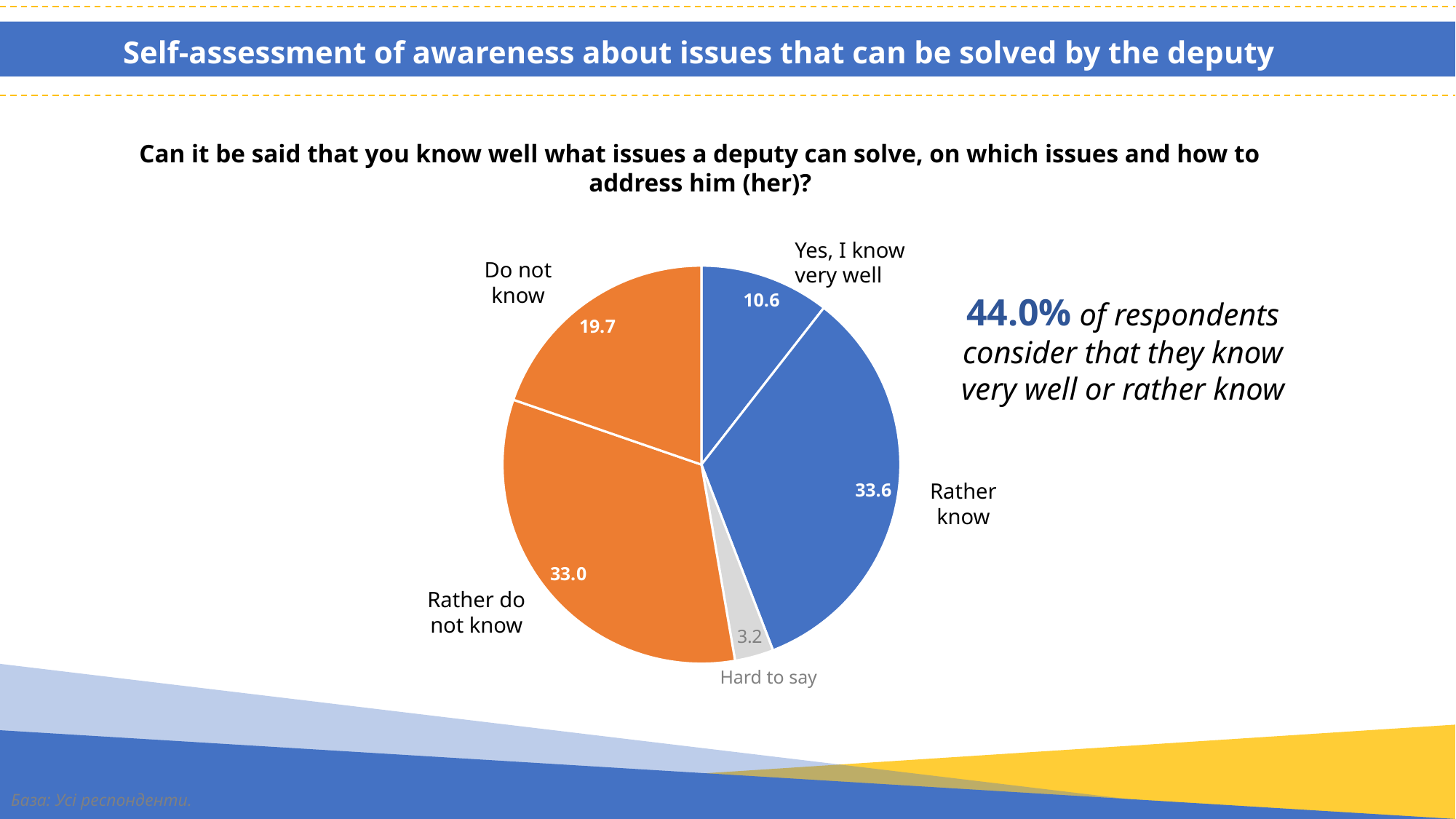
How many slices does the pie chart have? 5 Which is larger: the value for "Do not know" or the value for "Yes, I know very well"? Do not know What type of chart is shown on the slide? Pie chart What is the value for "Rather know" in the pie chart? 33.6 Which category has the smallest slice in the pie chart? Hard to say What is the value for "Rather do not know" in the pie chart? 33.0 What is the value for "Do not know" in the pie chart? 19.7 What is the title of the slide containing the pie chart? Self-assessment of awareness about issues that can be solved by the deputy What is the difference between the values for "Rather know" and "Yes, I know very well"? 23.0 What is the difference between the values for "Rather do not know" and "Do not know"? 13.3 What is the value for "Yes, I know very well" in the pie chart? 10.6 Which category has the largest slice in the pie chart? Rather know